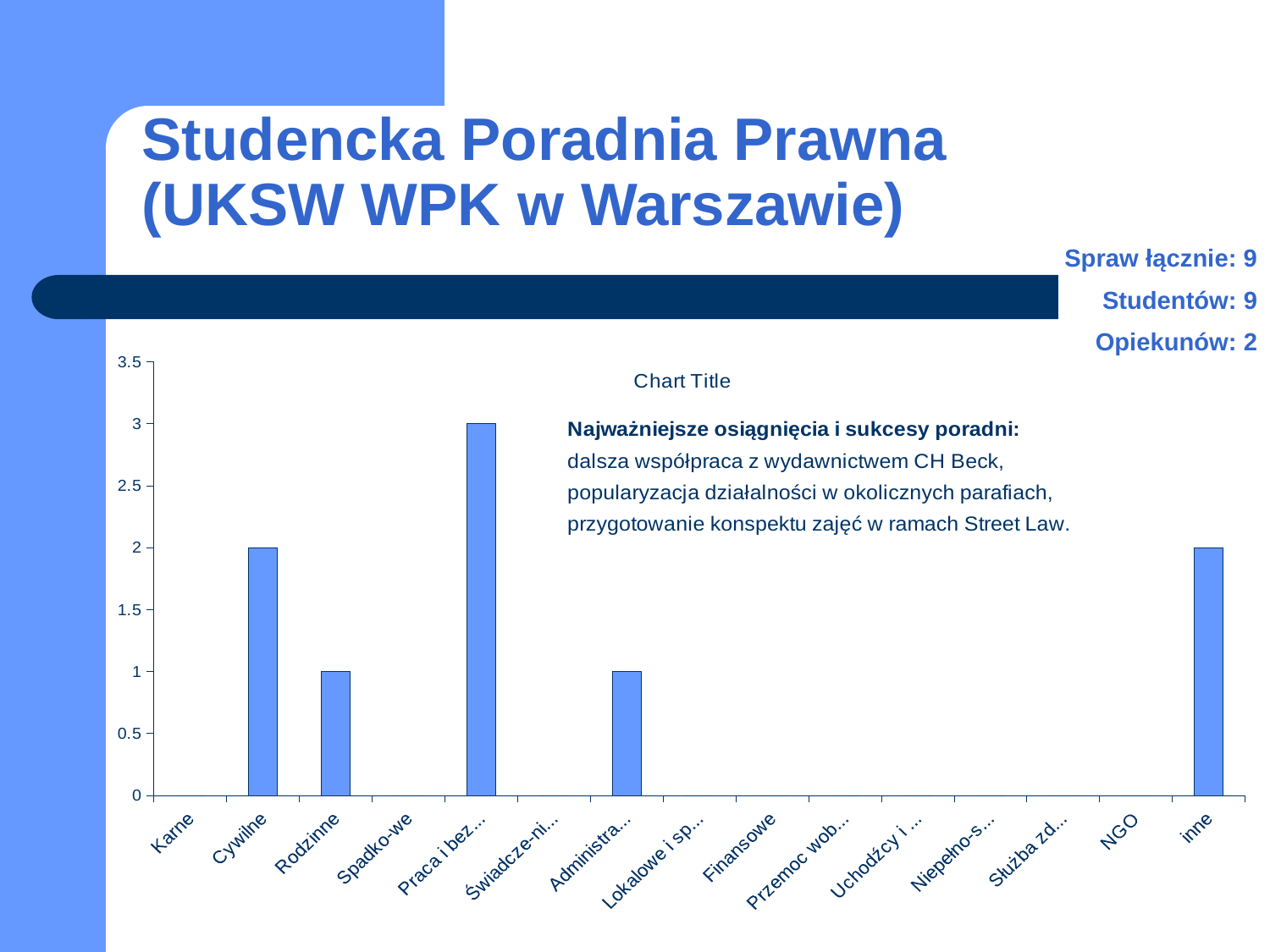
What is the value for Cywilne? 2 What is the value for Rodzinne? 1 What is the difference between the values for Cywilne and Rodzinne? 1 How many categories are shown on the x axis? 15 What type of chart is shown on the slide? bar chart Is the value for Praca i bez... greater or less than 2.5? greater What is the value for Karne? 0 Which is larger, the value for Cywilne or the value for Rodzinne? Cywilne What is the value for inne? 2 What is the value for NGO? 0 What is the title of the chart? Chart Title Which category has the highest value? Praca i bez...